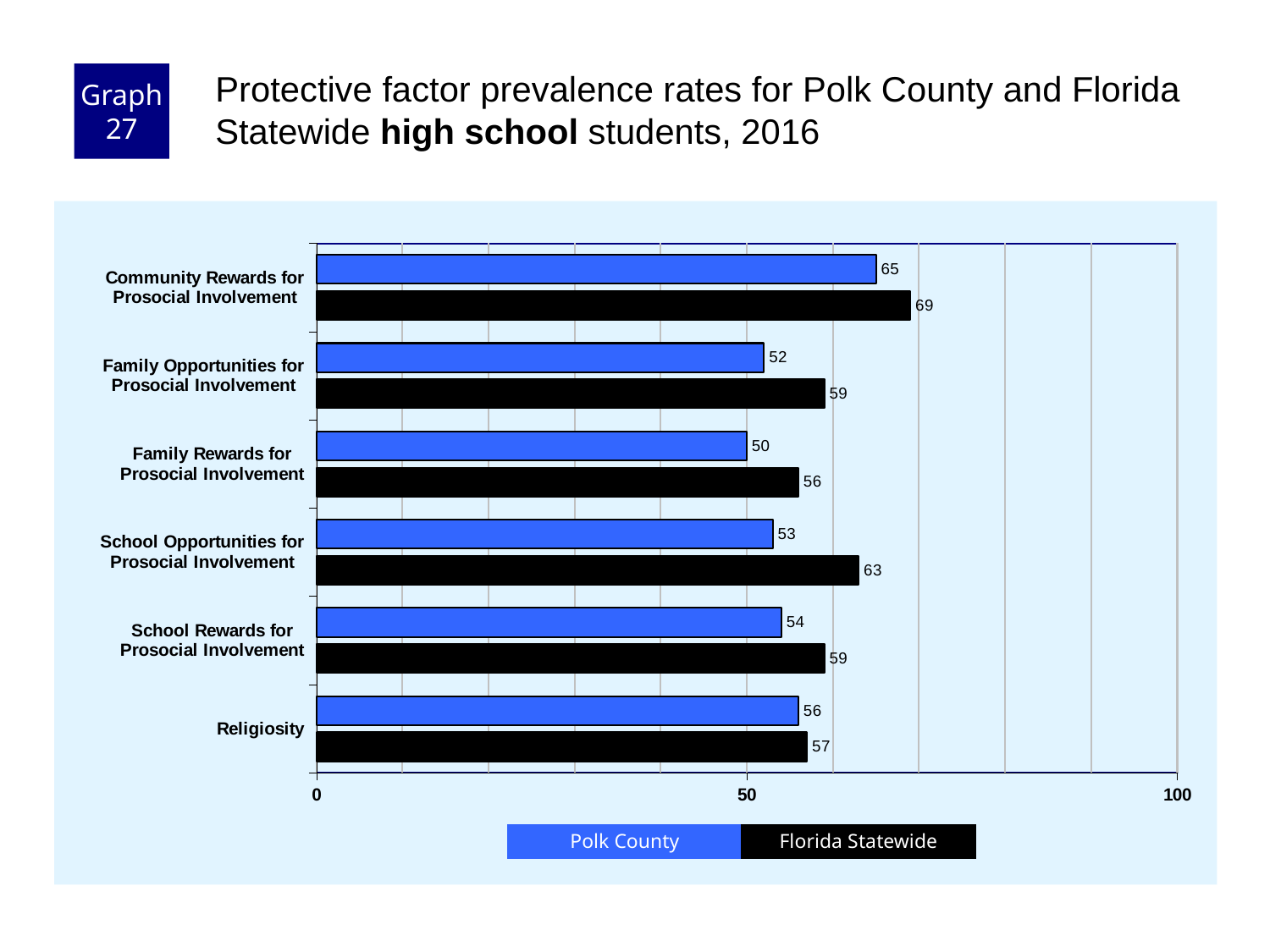
How many series does the legend list? 2 What is the Polk County value for Community Rewards for Prosocial Involvement? 65 What is the difference between the Florida Statewide and Polk County values for School Opportunities for Prosocial Involvement? 10 Which colour represents Florida Statewide in the chart? Black What is the Polk County value for Religiosity? 56 What kind of chart is shown on the slide? Bar chart Is the Florida Statewide value for Community Rewards for Prosocial Involvement greater or less than 50? greater What is the Florida Statewide value for School Opportunities for Prosocial Involvement? 63 Which protective factor has the highest Florida Statewide value? Community Rewards for Prosocial Involvement How many protective factors are shown on the chart? 6 Which is larger for Family Opportunities for Prosocial Involvement: the Polk County value or the Florida Statewide value? Florida Statewide Which protective factor has the lowest Polk County value? Family Rewards for Prosocial Involvement